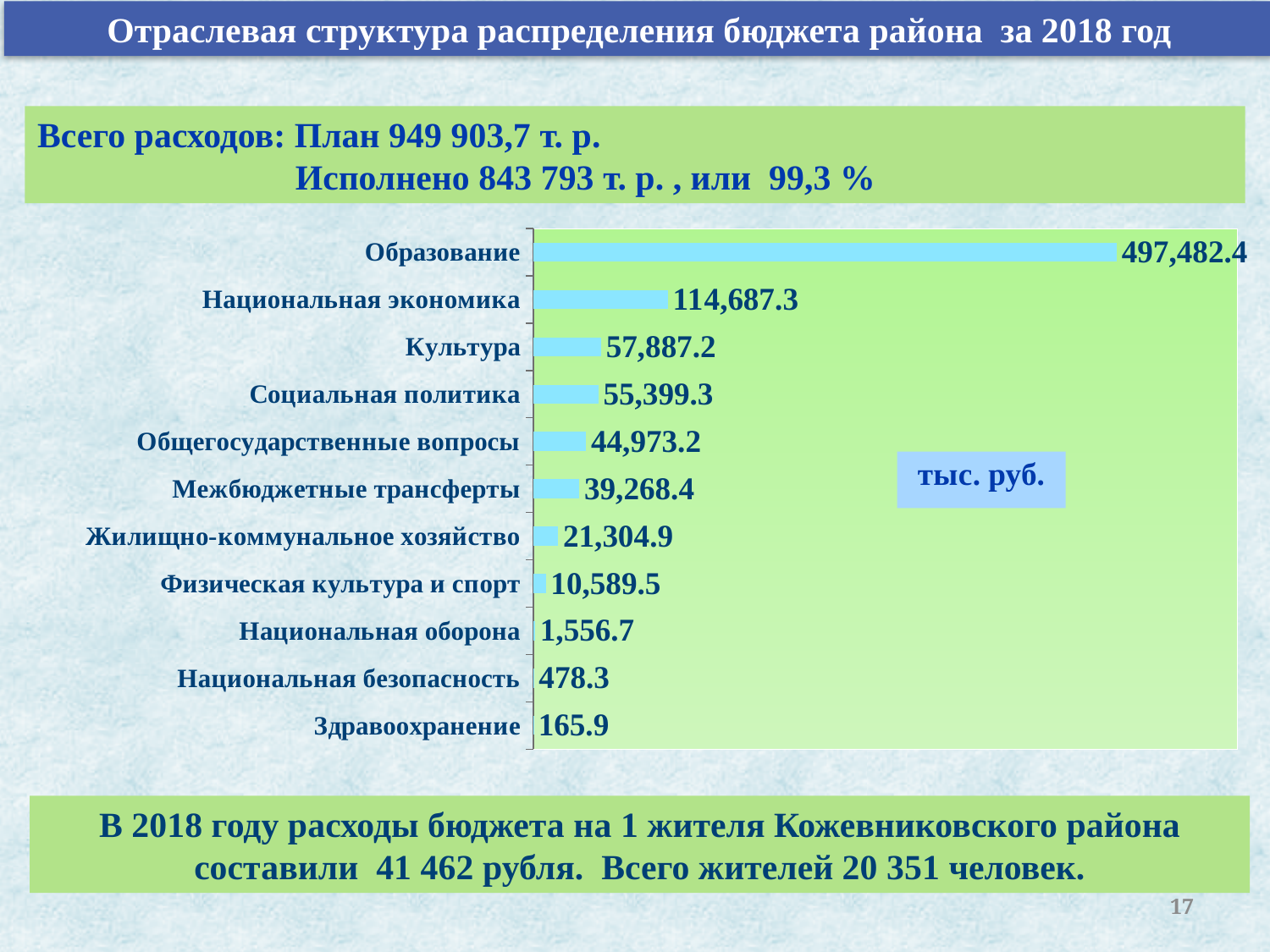
What is the value for Здравоохранение? 165.9 What is the value for Национальная экономика? 114,687.3 What is the difference between the values for Национальная оборона and Национальная безопасность? 1,078.4 What is the difference between the values for Образование and Национальная экономика? 382,795.1 What kind of chart is shown on the slide? Bar chart How many categories are shown in the chart? 11 What is the value for Жилищно-коммунальное хозяйство? 21,304.9 What unit is indicated in the label inside the chart area? тыс. руб. Which category has the lowest value? Здравоохранение What is the value for Образование? 497,482.4 Which category has the highest value? Образование Which is larger, the value for Культура or the value for Социальная политика? Культура